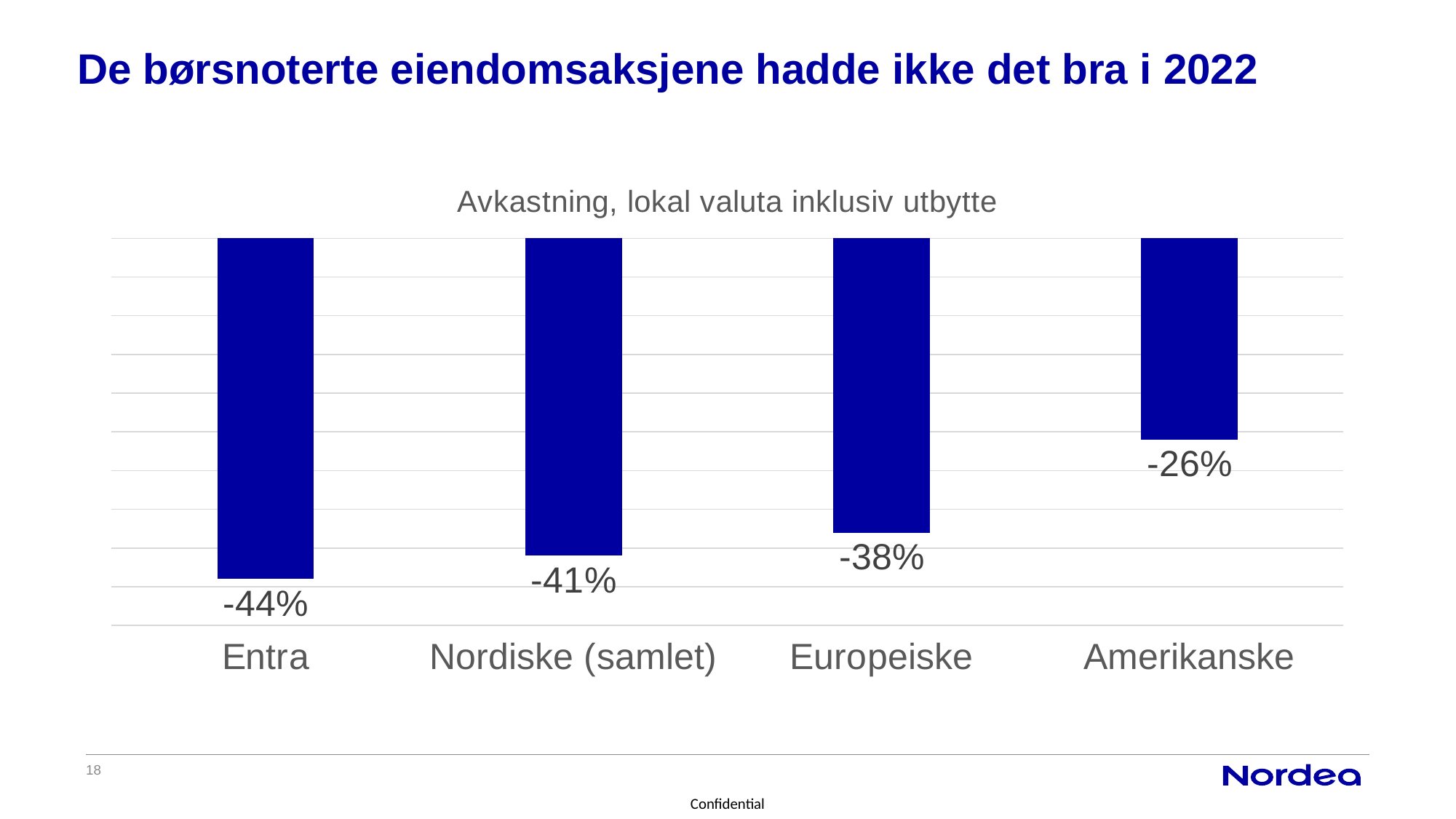
What is the difference between the values for Nordiske (samlet) and Europeiske? 3 percentage points Which is larger, the value for Europeiske or the value for Entra? Europeiske Which category has the highest value? Amerikanske What is the value for Nordiske (samlet)? -41% Which category has the lowest value? Entra What is the value for Entra? -44% How many categories are shown in the chart? 4 What is the value for Amerikanske? -26% What is the title of the chart? Avkastning, lokal valuta inklusiv utbytte What kind of chart is shown on the slide? Bar chart What is the value for Europeiske? -38% What is the difference between the values for Entra and Amerikanske? 18 percentage points